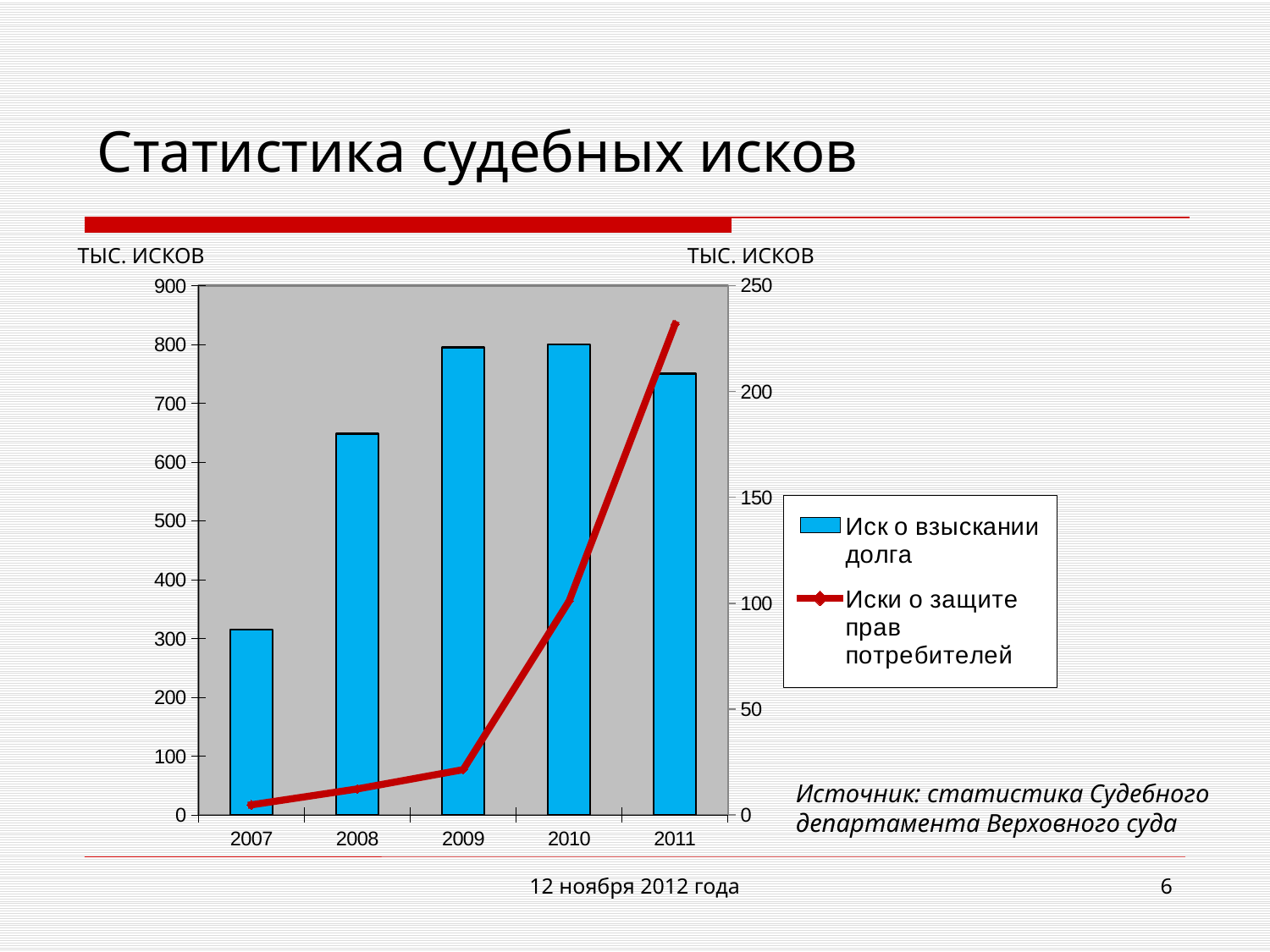
What kind of chart is shown on the slide? A combined bar and line chart Is the value of 'Иски о защите прав потребителей' in 2011 greater or less than 200 on the right axis? greater Which year has the lowest bar for 'Иск о взыскании долга'? 2007 How many years are shown on the x axis of the chart? 5 In which year is the line 'Иски о защите прав потребителей' at its lowest? 2007 What unit label is shown above the left axis of the chart? ТЫС. ИСКОВ Is the bar for 'Иск о взыскании долга' in 2007 greater or less than 400? less Is the bar for 'Иск о взыскании долга' in 2008 greater or less than 600? greater Does the line 'Иски о защите прав потребителей' rise or fall from 2007 to 2011? Rises Which year has the larger bar for 'Иск о взыскании долга': 2008 or 2011? 2011 How many series does the chart legend list? 2 In which year does the line 'Иски о защите прав потребителей' reach its highest value? 2011